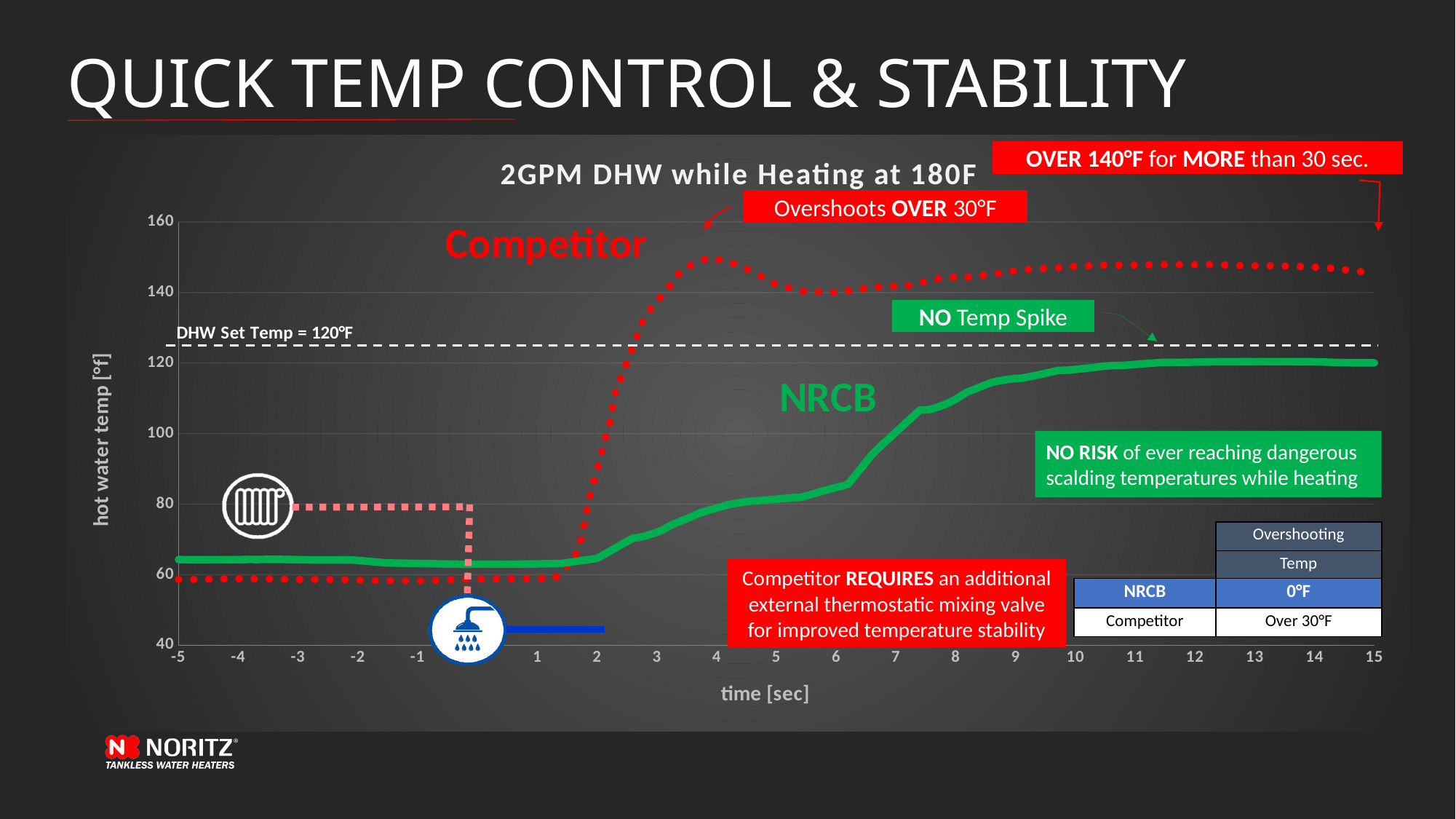
What is the title of the chart? 2GPM DHW while Heating at 180F What is the DHW Set Temp shown by the dashed line on the chart? 120°F Is the Competitor value at time 4 sec greater or less than 140? greater What kind of chart is shown on the slide? line chart How many data series are plotted on the chart? 2 Is the NRCB value at time 15 sec greater or less than 140? less Does the NRCB line rise or fall between time 2 sec and time 15 sec? rise Is the Competitor value at time 15 sec greater or less than 140? greater What is the label of the y axis of the chart? hot water temp [°F] According to the table on the slide, what is the Overshooting Temp for NRCB? 0°F At time 10 sec, which series has the higher hot water temp, Competitor or NRCB? Competitor